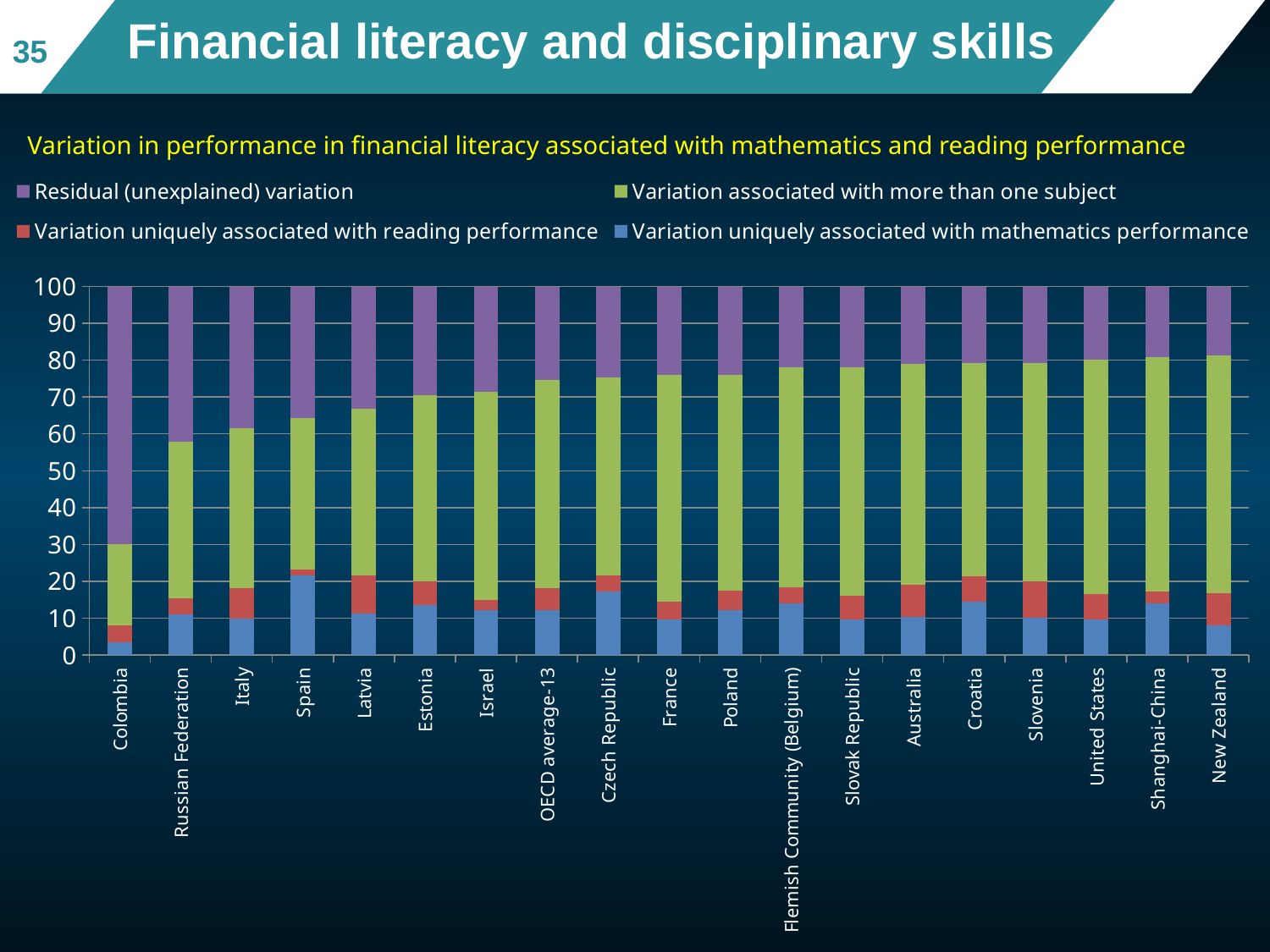
Is the combined value of the three lower segments (below the residual variation) for Colombia greater or less than 40? less What type of chart is shown on the slide? Stacked bar chart Which category has the smallest 'Variation uniquely associated with mathematics performance' segment? Colombia How many countries/economies (categories) are shown on the x axis of the chart? 19 What is the total height of the stacked bar for Colombia? 100 Which category has the largest 'Variation uniquely associated with mathematics performance' segment? Spain Is the 'Residual (unexplained) variation' segment larger for Colombia or for New Zealand? Colombia What is the title of the chart? Variation in performance in financial literacy associated with mathematics and reading performance Is the combined value of the three lower segments (below the residual variation) for New Zealand greater or less than 70? greater Moving from left to right along the x axis, does the 'Residual (unexplained) variation' segment generally get larger or smaller? smaller How many series does the chart legend list? 4 Which category has the largest 'Residual (unexplained) variation' segment? Colombia